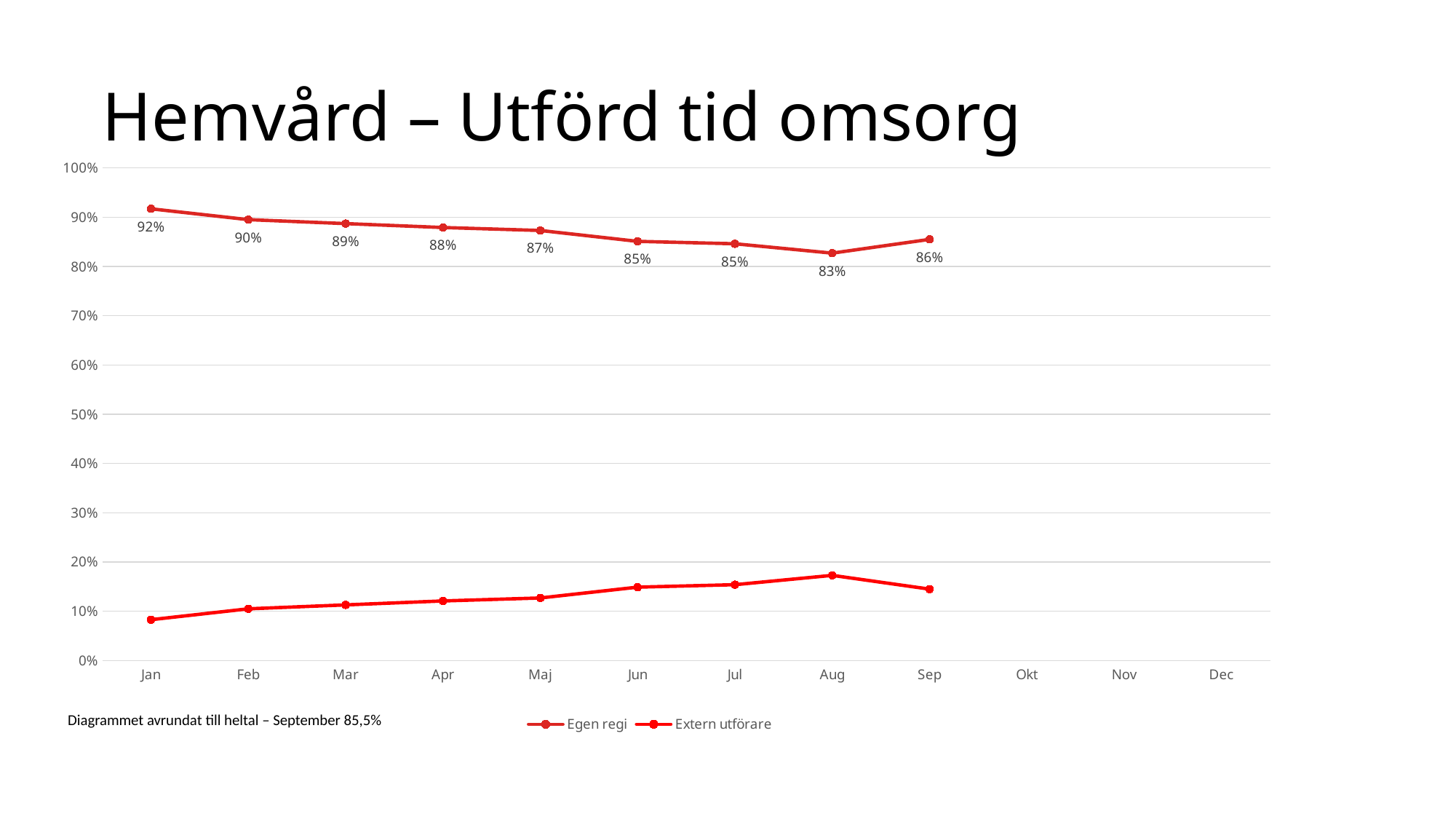
Is the value for Extern utförare in Aug greater or less than 20%? less In which month is the Egen regi value highest? Jan What is the value for Egen regi in Jan? 92% Does the Egen regi line generally rise or fall from Jan to Aug? fall How many series does the legend list? 2 What is the value for Egen regi in Aug? 83% In which month is the Egen regi value lowest? Aug What is the difference between the Egen regi values in Jan and Aug? 9% What type of chart is shown on the slide? line chart Which is larger, the Egen regi value in Mar or in Maj? Mar What is the value for Egen regi in Sep? 86% Is the value for Extern utförare in Jan greater or less than 10%? less